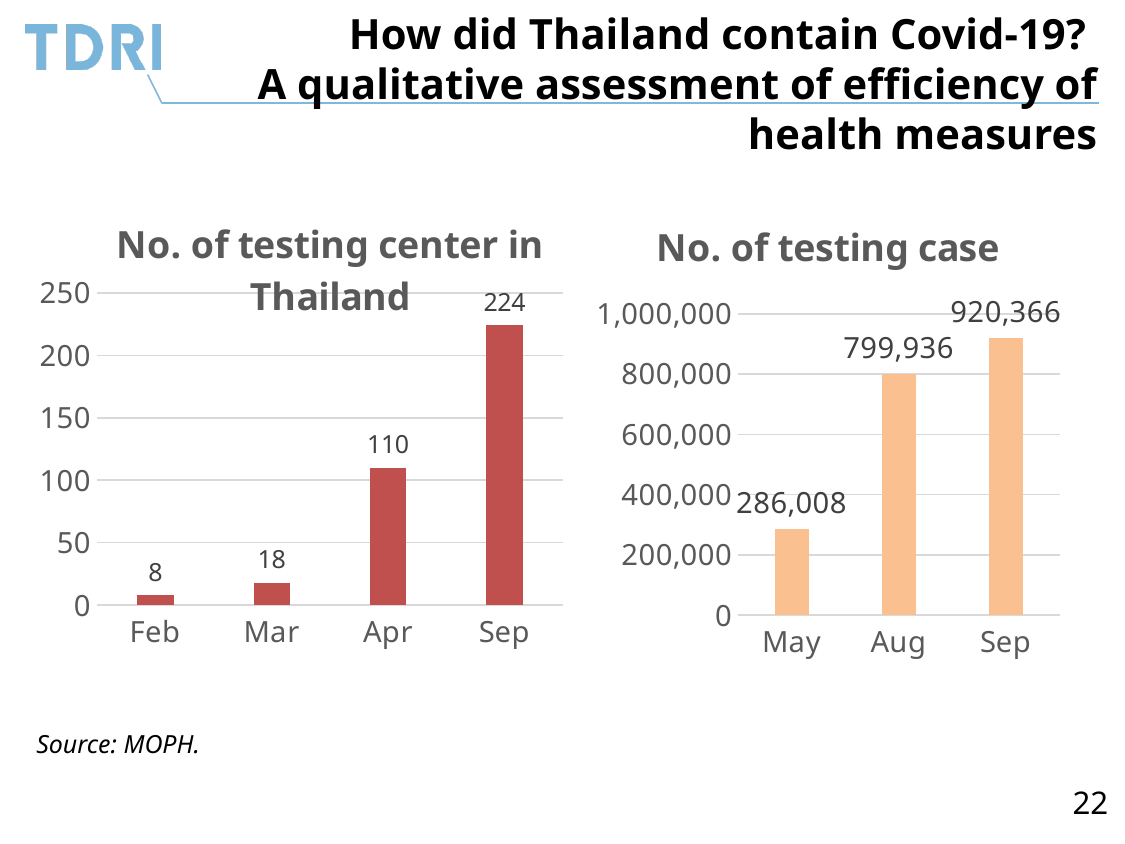
In the 'No. of testing case' chart, is the value for Sep greater or less than 800,000? greater What kind of chart is the 'No. of testing case' chart? bar chart In the 'No. of testing center in Thailand' chart, how many months are shown on the x axis? 4 In the 'No. of testing center in Thailand' chart, what is the difference between the values for Sep and Apr? 114 In the 'No. of testing case' chart, which month has the highest value? Sep In the 'No. of testing center in Thailand' chart, which month has the lowest value? Feb In the 'No. of testing case' chart, what is the value for Aug? 799,936 In the 'No. of testing center in Thailand' chart, what is the value for Apr? 110 In the 'No. of testing center in Thailand' chart, do the values rise or fall from Feb to Sep? rise In the 'No. of testing center in Thailand' chart, which month has the highest value? Sep In the 'No. of testing case' chart, what is the value for May? 286,008 In the 'No. of testing center in Thailand' chart, what is the value for Feb? 8